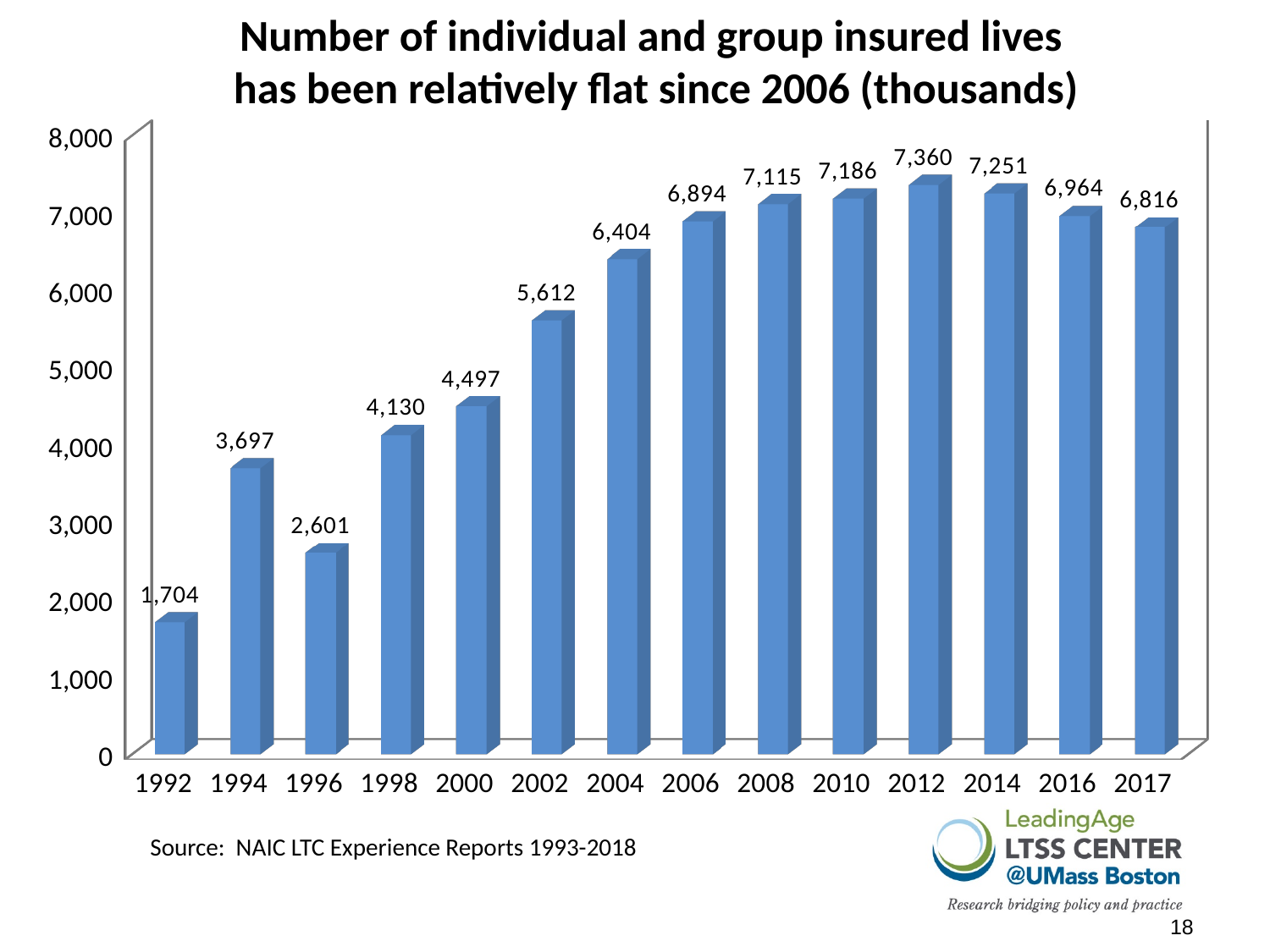
Which is larger, the value for 1994 or the value for 1996? 1994 What is the value for 2012? 7,360 How many years are shown on the x axis? 14 Is the value for 2002 greater or less than 5,000? greater What is the difference between the values for 1994 and 1996? 1,096 Do the values rise or fall from 1996 to 2012? rise What kind of chart is shown on the slide? bar chart What is the value for 2017? 6,816 Which year has the highest value? 2012 Which year has the lowest value? 1992 What is the difference between the values for 2012 and 2017? 544 What is the value for 1992? 1,704